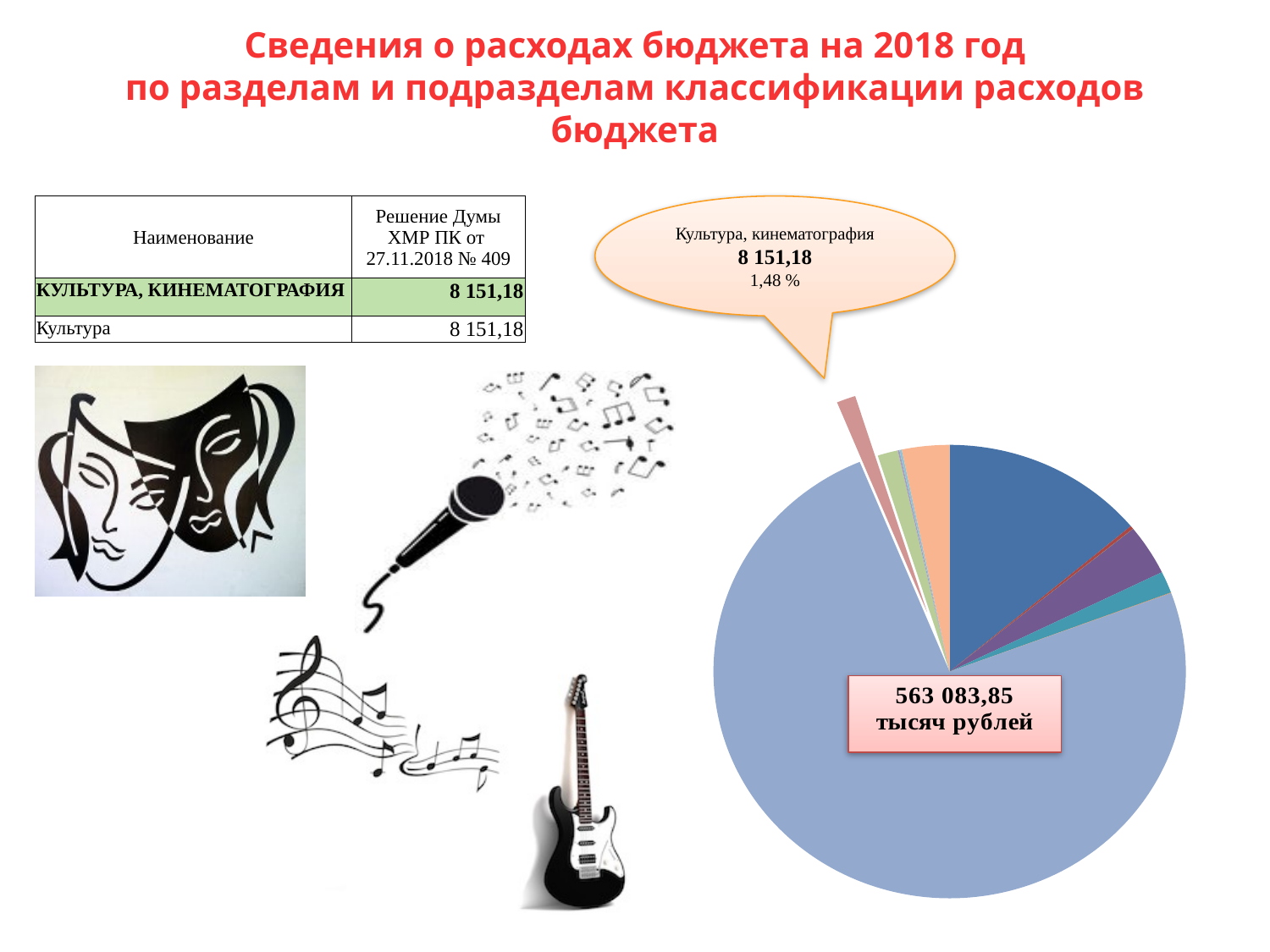
What share of the pie does the Культура, кинематография slice represent, according to the callout? 1,48 % Is the Культура, кинематография slice the largest slice of the pie chart? No Which category does the slice pulled out from the pie chart correspond to? Культура, кинематография Which budget year does the slide's chart refer to? 2018 What total is printed on the pie chart? 563 083,85 тысяч рублей What is the value shown in the callout for Культура, кинематография on the pie chart? 8 151,18 What kind of chart is shown on the slide? pie chart